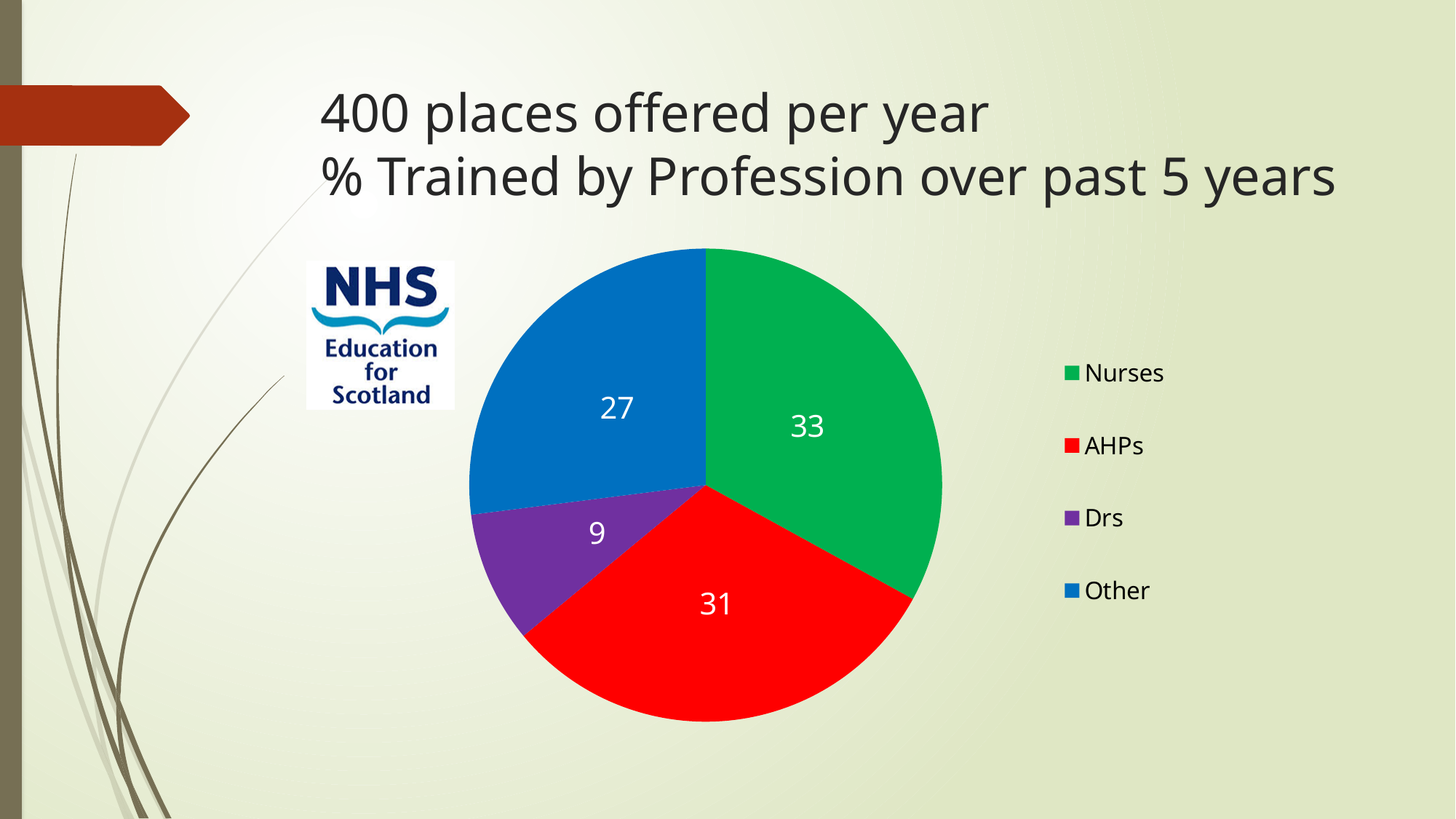
What kind of chart is shown on the slide? pie chart What is the value for Nurses? 33 Which category has the largest slice? Nurses What is the value for Other? 27 What is the value for AHPs? 31 How many categories does the pie chart have? 4 Which is larger, the value for Other or the value for Drs? Other What colour is the slice for AHPs? red What is the difference between the values for Nurses and Drs? 24 Which category has the smallest slice? Drs What is the difference between the values for AHPs and Other? 4 What is the value for Drs? 9